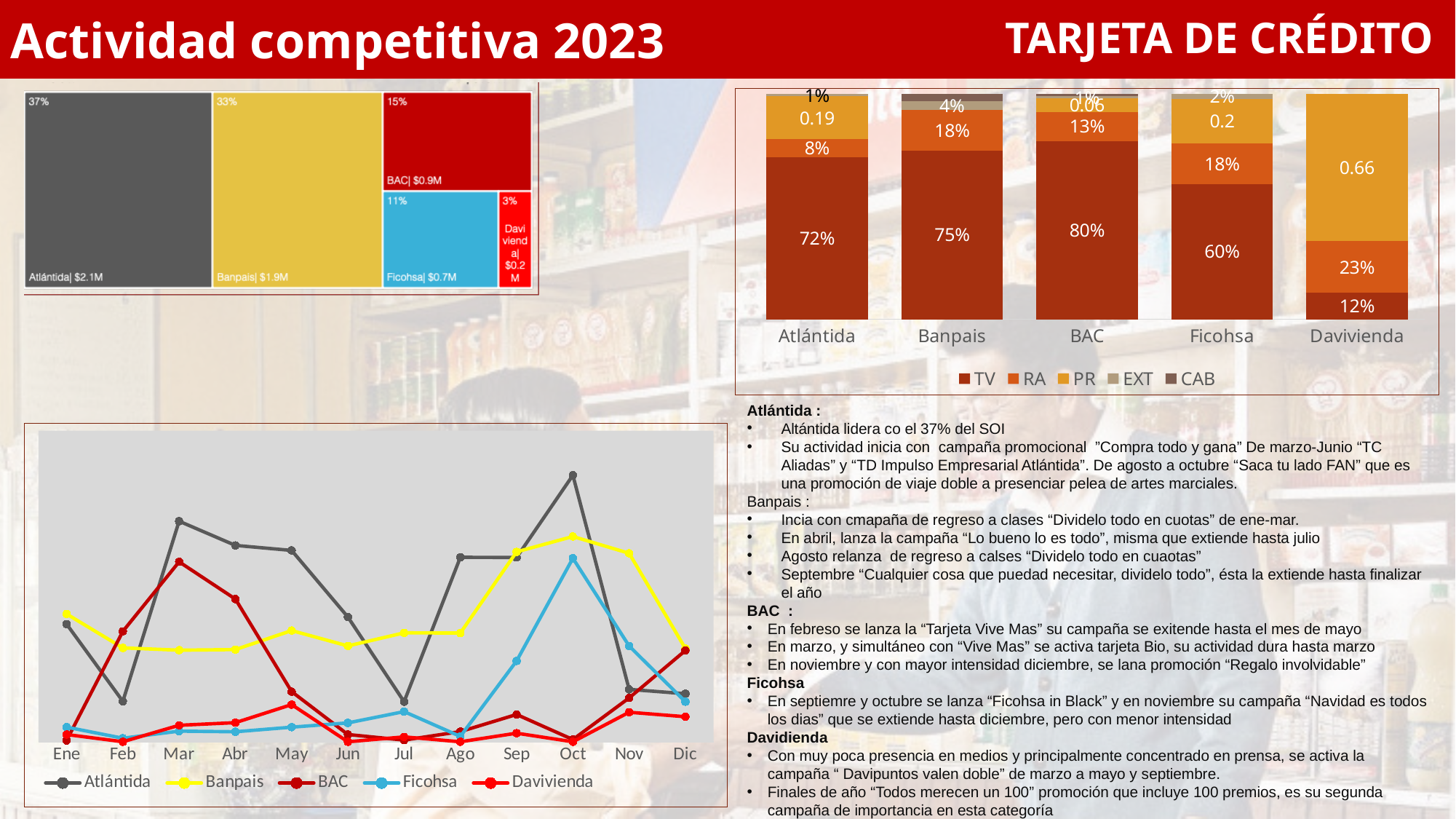
In the stacked bar chart at the top right, how many series does the legend list? 5 In the stacked bar chart at the top right, is the TV share for Ficohsa larger or smaller than the TV share for Banpais? smaller In the treemap at the top left, what dollar value is shown for Banpais? $1.9M In the line chart at the bottom left, how many months are shown on the x axis? 12 In the stacked bar chart at the top right, what is the RA share for Davivienda? 23% In the treemap at the top left, what share does Atlántida hold? 37% In the line chart at the bottom left, in which month does the Atlántida line reach its highest point? Oct What type of chart is shown at the bottom left of the slide? Line chart In the stacked bar chart at the top right, which brand has the lowest TV share? Davivienda In the treemap at the top left, what is the difference in percentage points between Atlántida's share and BAC's share? 22 In the treemap at the top left, which brand has the smallest share? Davivienda In the stacked bar chart at the top right, what is the TV share for BAC? 80%